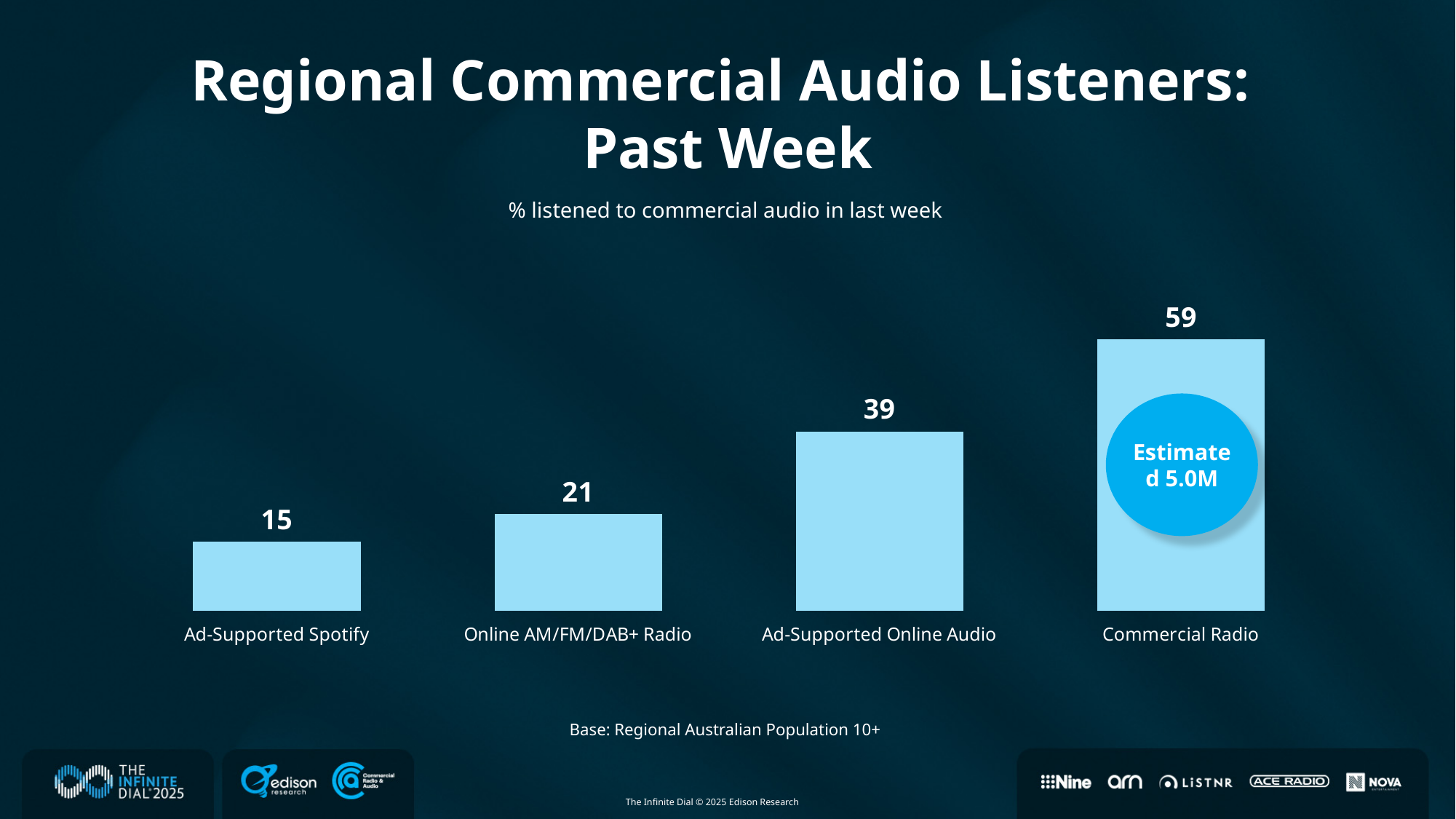
What estimated number of listeners is shown in the circle on the Commercial Radio bar? Estimated 5.0M Which category has the lowest value? Ad-Supported Spotify Which category has the highest value? Commercial Radio What is the difference between the values for Online AM/FM/DAB+ Radio and Ad-Supported Spotify? 6 What is the difference between the values for Commercial Radio and Ad-Supported Online Audio? 20 What is the value for Ad-Supported Online Audio? 39 What kind of chart is shown on the slide? Bar chart What is the value for Commercial Radio? 59 Which is larger, the value for Ad-Supported Online Audio or the value for Online AM/FM/DAB+ Radio? Ad-Supported Online Audio How many categories are shown in the chart? 4 What is the value for Online AM/FM/DAB+ Radio? 21 What is the value for Ad-Supported Spotify? 15